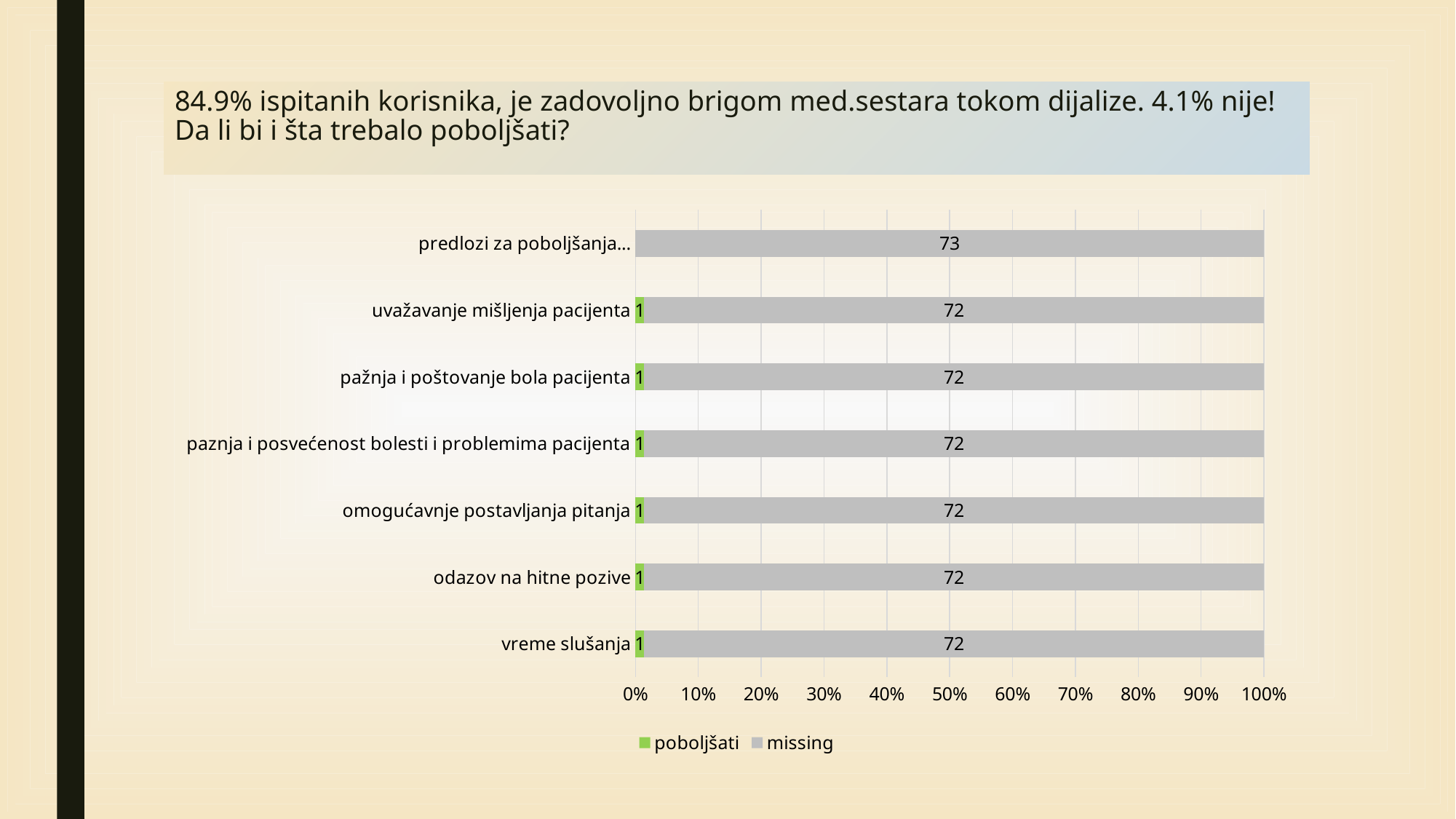
What is the 'poboljšati' value for 'uvažavanje mišljenja pacijenta'? 1 What is the total of the stacked bar for 'pažnja i poštovanje bola pacijenta'? 73 How many categories are plotted on the chart? 7 What is the difference between the 'missing' value for 'predlozi za poboljšanja...' and the 'missing' value for 'omogućavnje postavljanja pitanja'? 1 What is the 'missing' value for 'predlozi za poboljšanja...'? 73 What is the 'poboljšati' value for 'odazov na hitne pozive'? 1 What is the 'missing' value for 'vreme slušanja'? 72 What are the two series named in the legend? poboljšati and missing What kind of chart is shown on the slide? bar chart Which colour represents the 'missing' series? grey Which category has the highest 'missing' value? predlozi za poboljšanja... How many series does the legend list? 2